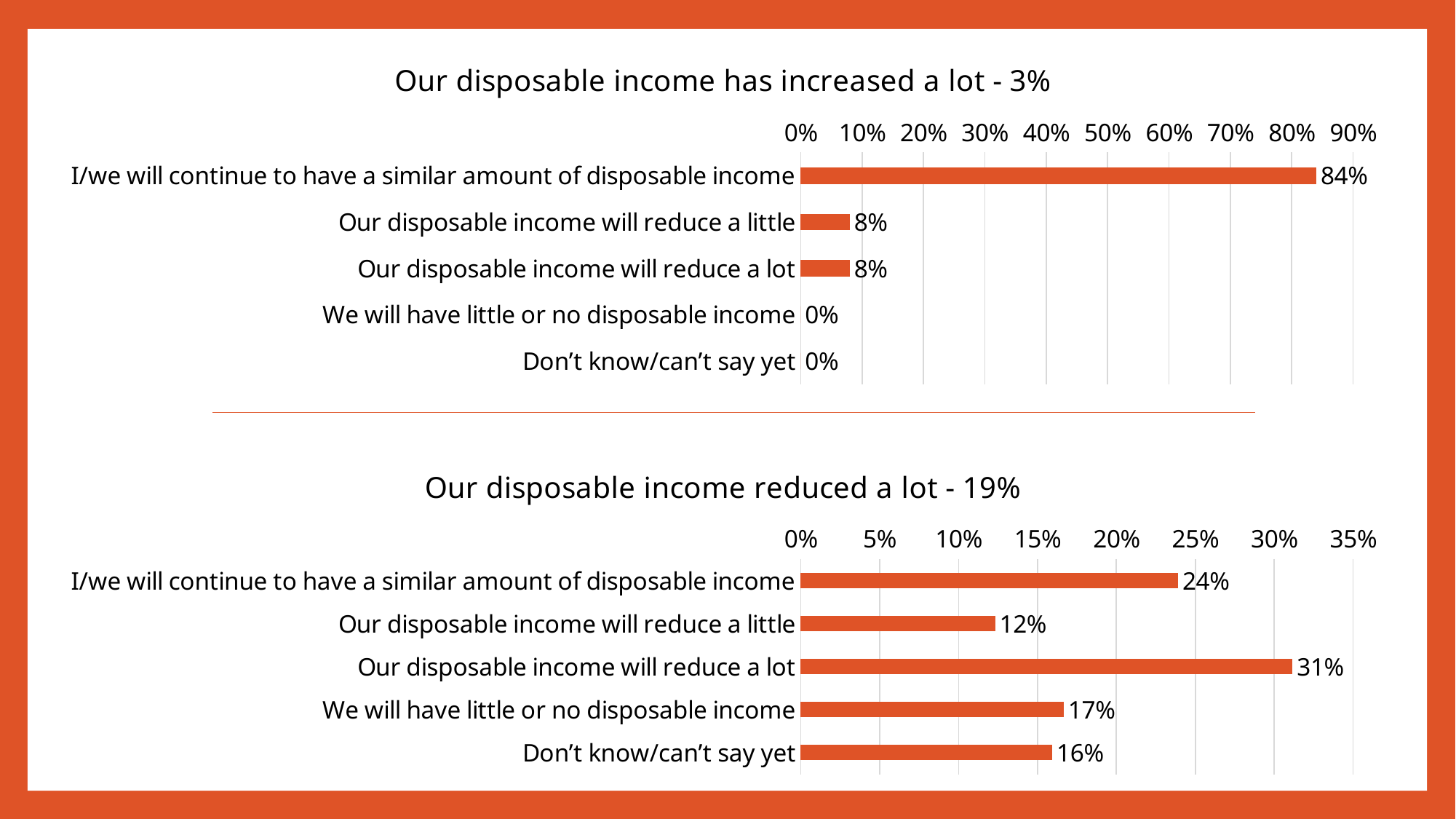
In the chart titled 'Our disposable income reduced a lot - 19%', which category has the lowest value? Our disposable income will reduce a little In the chart titled 'Our disposable income reduced a lot - 19%', what is the value for 'Our disposable income will reduce a lot'? 31% What type of chart is the chart titled 'Our disposable income reduced a lot - 19%'? Bar chart In the chart titled 'Our disposable income has increased a lot - 3%', what is the value for 'I/we will continue to have a similar amount of disposable income'? 84% In the chart titled 'Our disposable income has increased a lot - 3%', what is the difference between 'I/we will continue to have a similar amount of disposable income' and 'Our disposable income will reduce a little'? 76% How many categories does the chart titled 'Our disposable income has increased a lot - 3%' show? 5 In the chart titled 'Our disposable income has increased a lot - 3%', which category has the highest value? I/we will continue to have a similar amount of disposable income In the chart titled 'Our disposable income reduced a lot - 19%', what is the value for 'Don't know/can't say yet'? 16% In the chart titled 'Our disposable income reduced a lot - 19%', which category has the highest value? Our disposable income will reduce a lot In the chart titled 'Our disposable income reduced a lot - 19%', what is the difference between 'Our disposable income will reduce a lot' and 'Our disposable income will reduce a little'? 19% In the chart titled 'Our disposable income reduced a lot - 19%', which is larger: 'We will have little or no disposable income' or 'Don't know/can't say yet'? We will have little or no disposable income In the chart titled 'Our disposable income has increased a lot - 3%', how many categories have a value of 0%? 2